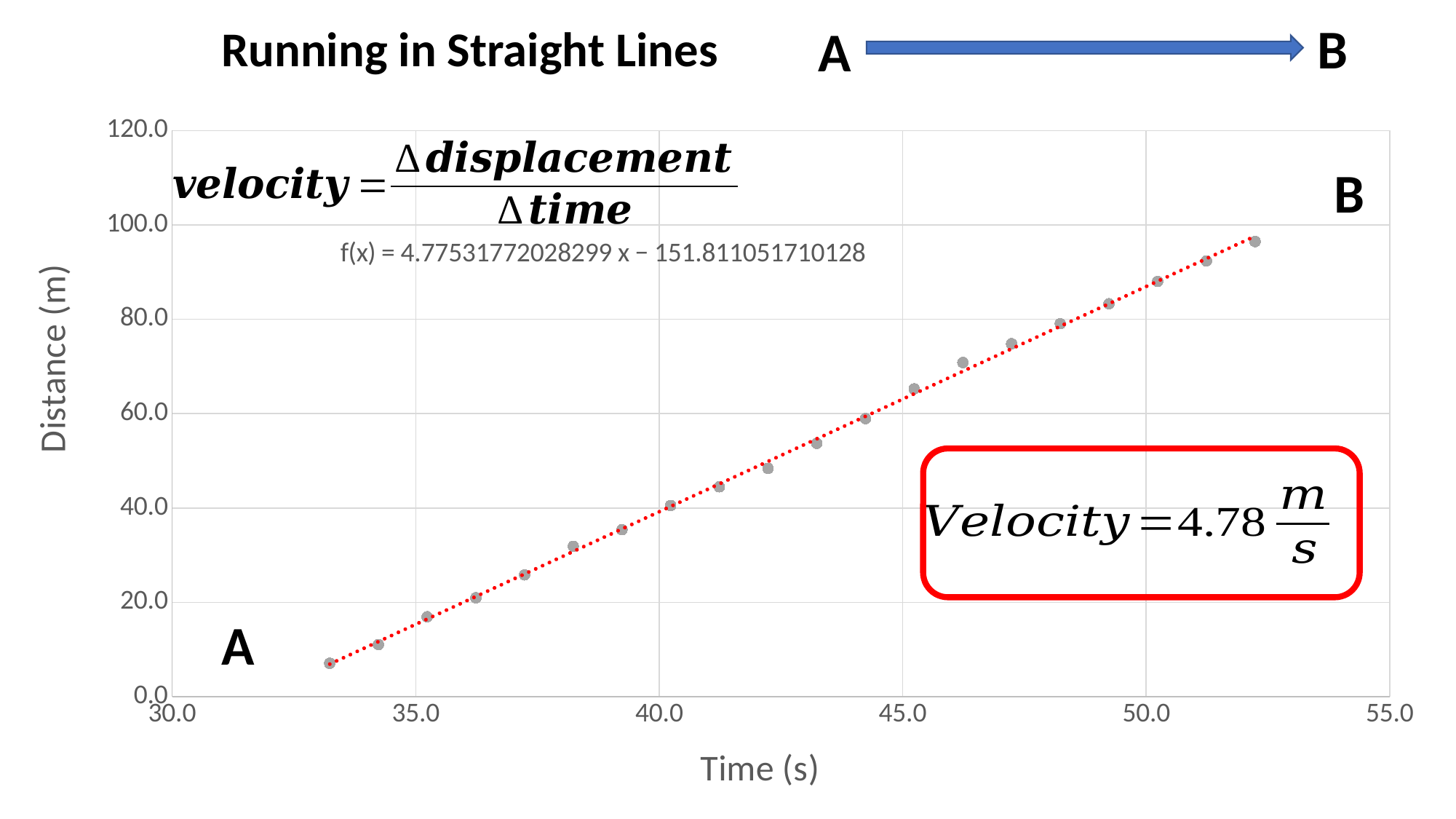
Is the distance value at time 40.0 s greater or less than 60.0? less Do the distance values rise or fall as time increases along the x axis? Rise Is the distance value at time 45.0 s greater or less than 40.0? greater What is the label of the y axis? Distance (m) What is the maximum value shown on the y axis? 120.0 What is the title of the chart? Running in Straight Lines What is the slope of the trendline equation shown on the chart? 4.77531772028299 Which data point has the highest distance value, the leftmost or the rightmost? Rightmost Is the distance value at the first (leftmost) data point greater or less than 20.0? less What kind of chart is shown on the slide? Scatter chart What velocity value is shown in the red box on the chart? 4.78 m/s